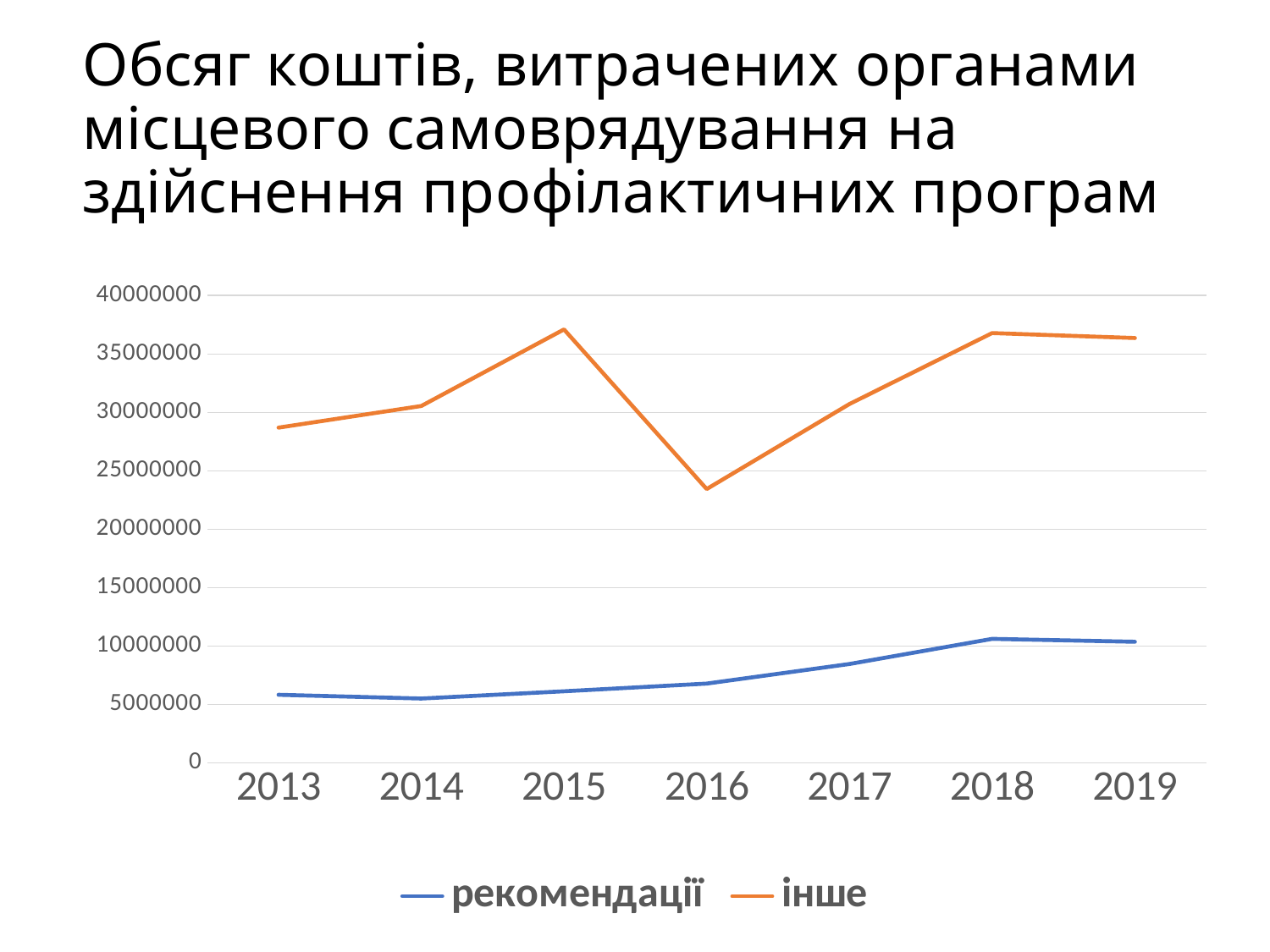
Which colour is used for the інше series? orange Is the value for інше in 2016 greater or less than 25000000? less Is the value for рекомендації in 2017 greater or less than 10000000? less Is the value for рекомендації in 2018 greater or less than 10000000? greater Does the value for рекомендації rise or fall from 2014 to 2018? rise How many series does the legend list? 2 In which year is the value for інше lowest? 2016 How many years are plotted along the x axis? 7 What kind of chart is shown on the slide? line chart Which series has the larger value in 2016, рекомендації or інше? інше